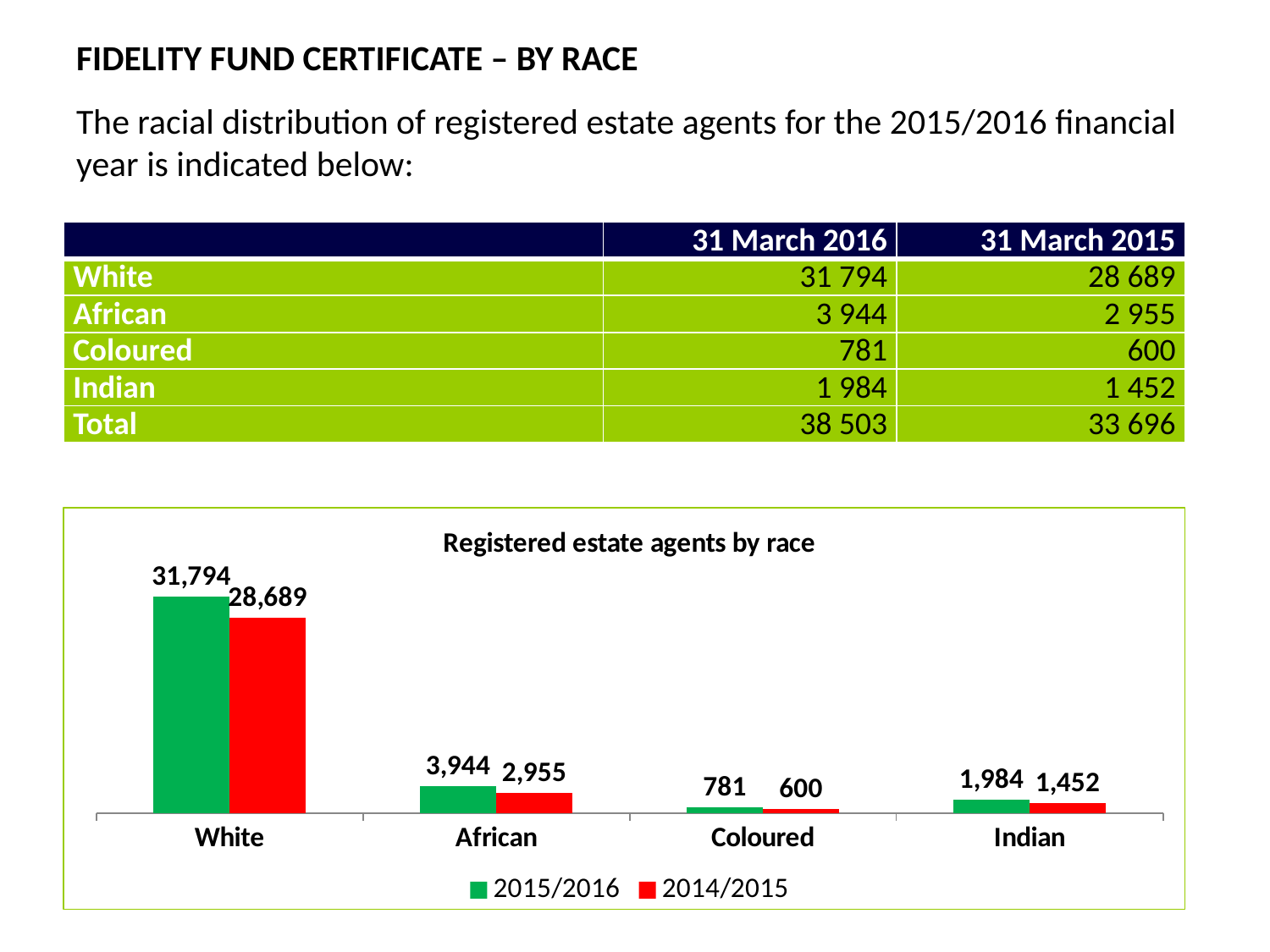
What is the value for African in the 2014/2015 series? 2,955 What is the value for Indian in the 2014/2015 series? 1,452 What type of chart is shown on the slide? Bar chart Which is larger for African: the 2015/2016 value or the 2014/2015 value? 2015/2016 Which category has the lowest value in the 2014/2015 series? Coloured What is the value for Coloured in the 2015/2016 series? 781 What is the difference between the 2015/2016 and 2014/2015 values for White? 3,105 How many categories are shown on the x axis of the chart? 4 How many series does the chart legend list? 2 What is the difference between the 2015/2016 and 2014/2015 values for Indian? 532 Which category has the highest value in the 2015/2016 series? White What is the value for White in the 2015/2016 series? 31,794